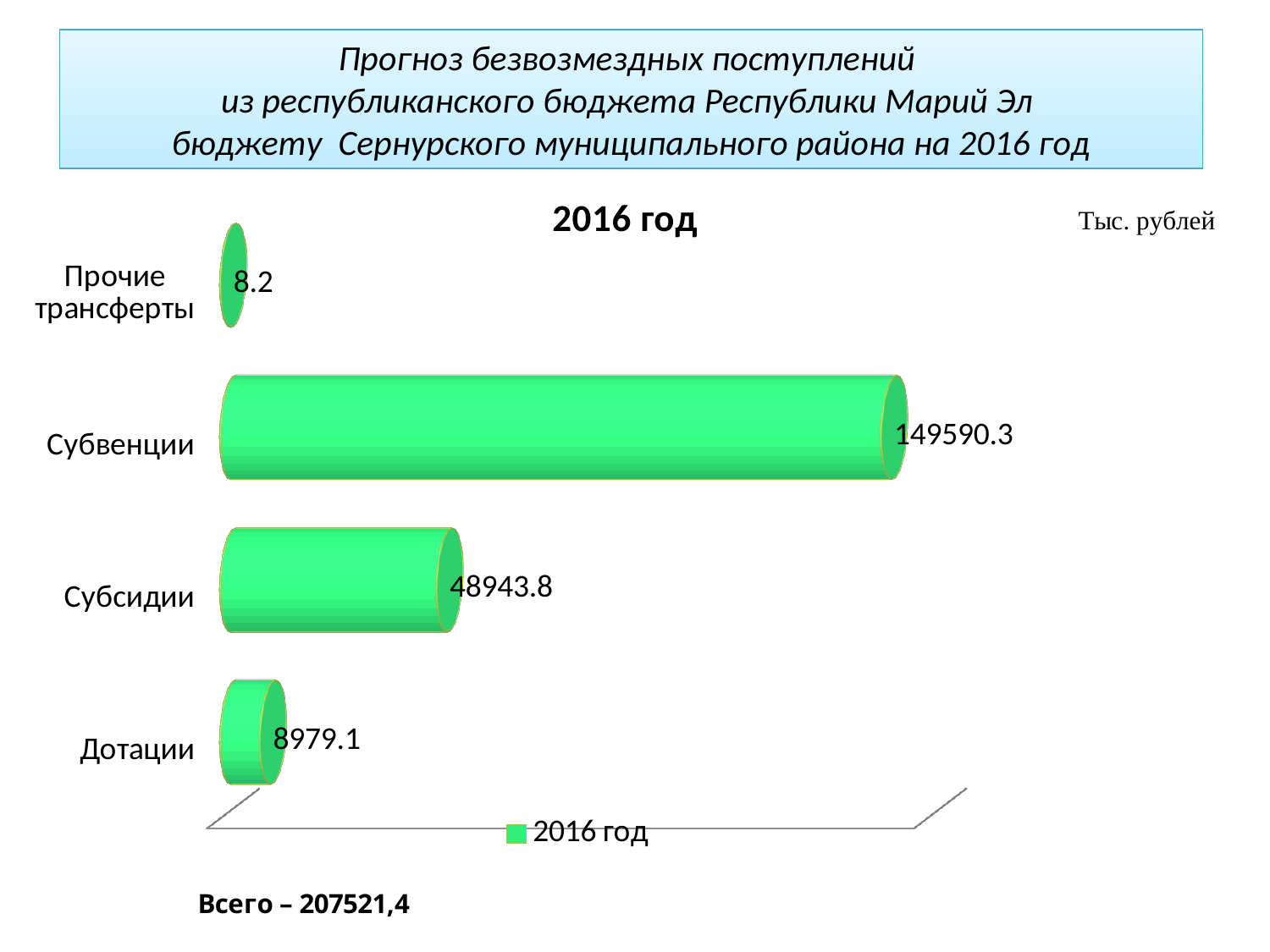
What is the difference between the values for Субсидии and Дотации? 39964.7 What is the difference between the values for Субвенции and Субсидии? 100646.5 What is the value for Прочие трансферты? 8.2 Which is larger, the value for Дотации or the value for Субсидии? Субсидии Which category has the highest value? Субвенции What is the title of the chart? 2016 год Which category has the lowest value? Прочие трансферты How many categories are shown in the chart? 4 What kind of chart is shown on the slide? Bar chart What is the value for Субвенции? 149590.3 What is the value for Дотации? 8979.1 What is the value for Субсидии? 48943.8